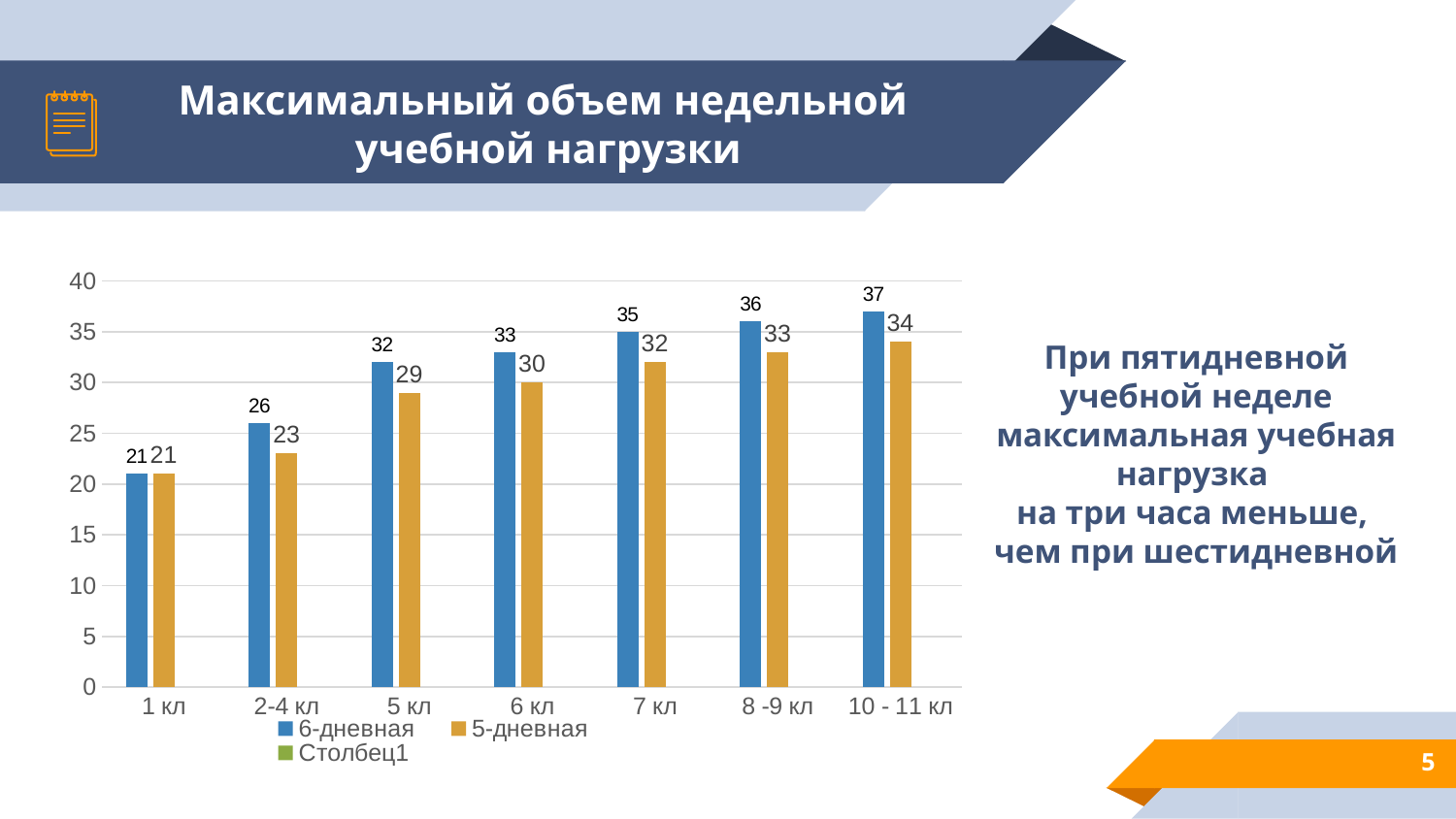
What kind of chart is shown on the slide? bar chart What is the difference between the 6-дневная and 5-дневная values in the 7 кл category? 3 Which is larger in the 6 кл category: the 6-дневная value or the 5-дневная value? 6-дневная Is the value for 5-дневная in the 10 - 11 кл category greater or less than 30? greater How many categories are shown on the x axis? 7 What is the value for 5-дневная in the 2-4 кл category? 23 Do the 6-дневная values rise or fall from 1 кл to 10 - 11 кл? rise How many series does the legend list? 3 Which category has the lowest value for the 5-дневная series? 1 кл What is the value for 5-дневная in the 8 -9 кл category? 33 What is the value for 6-дневная in the 5 кл category? 32 Which category has the highest value for the 6-дневная series? 10 - 11 кл